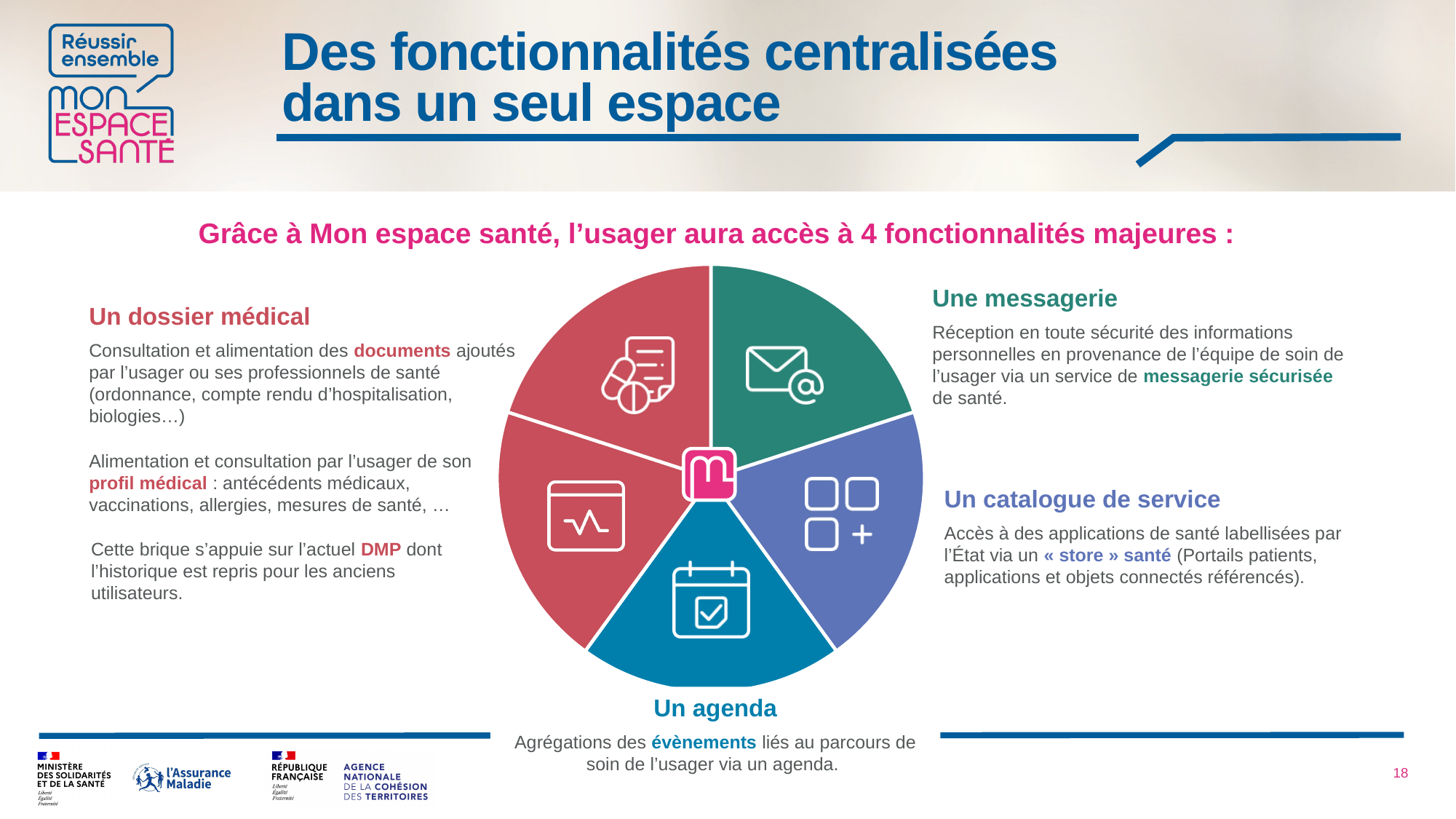
Which segment of the circular diagram is shown in blue at the bottom? Un agenda Is the red segment of the circular diagram larger or smaller than the green segment? larger What kind of chart is the diagram in the centre of the slide? pie chart What colour is the segment of the circular diagram labelled 'Une messagerie'? green How many segments does the circular diagram in the centre of the slide have? 4 Which segment of the circular diagram is the largest? Un dossier médical